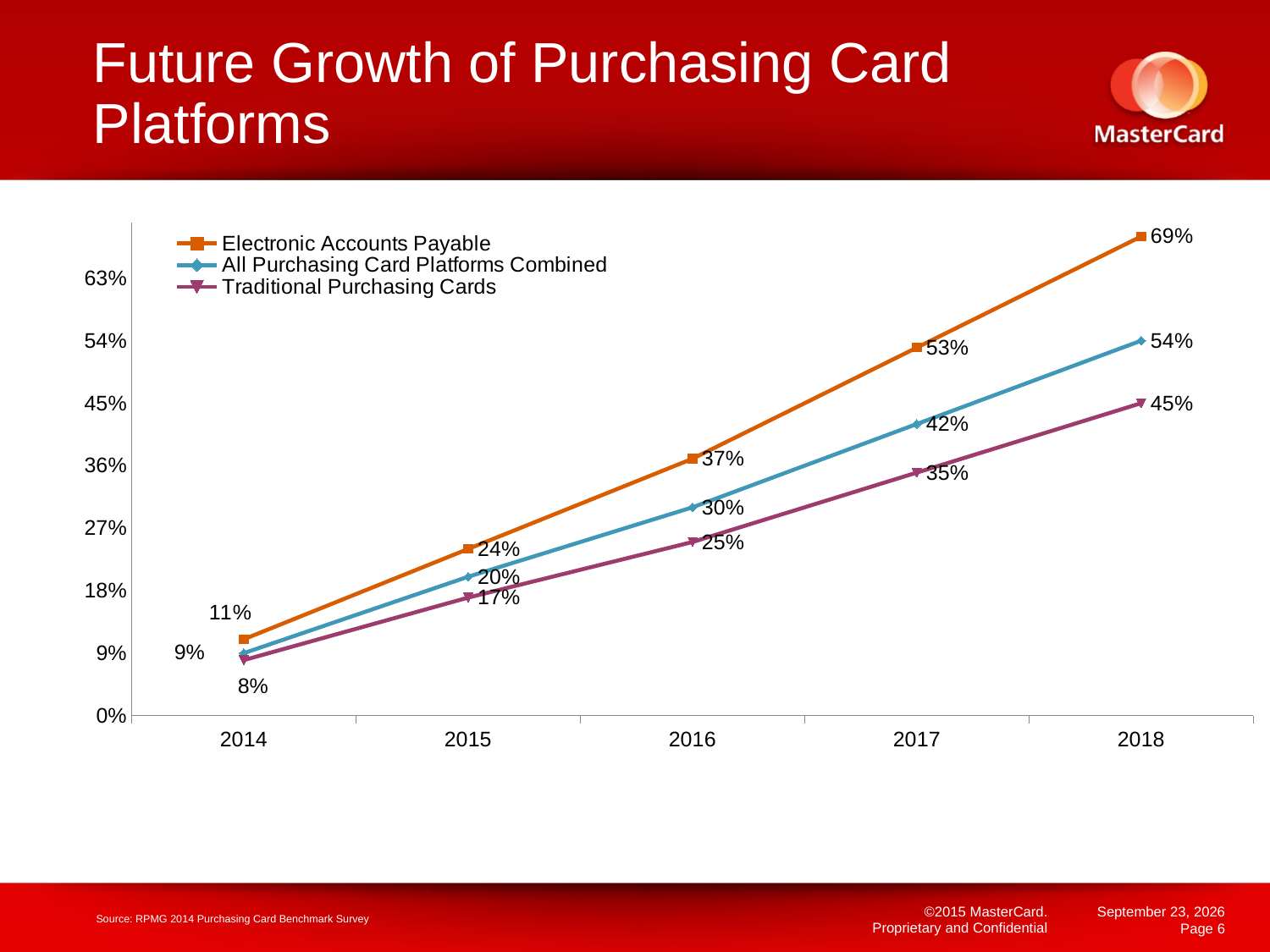
How many years are shown on the x axis? 5 How many series does the legend list? 3 What is the value for Traditional Purchasing Cards in 2016? 25% What is the value for Electronic Accounts Payable in 2018? 69% In which year is the Electronic Accounts Payable value highest? 2018 What is the value for All Purchasing Card Platforms Combined in 2017? 42% What is the difference between Electronic Accounts Payable and Traditional Purchasing Cards in 2018? 24% What kind of chart is shown on the slide? Line chart What is the source cited at the bottom of the slide? RPMG 2014 Purchasing Card Benchmark Survey Do the values for All Purchasing Card Platforms Combined rise or fall from 2014 to 2018? Rise Which is larger in 2017: Electronic Accounts Payable or All Purchasing Card Platforms Combined? Electronic Accounts Payable In which year is the Traditional Purchasing Cards value lowest? 2014